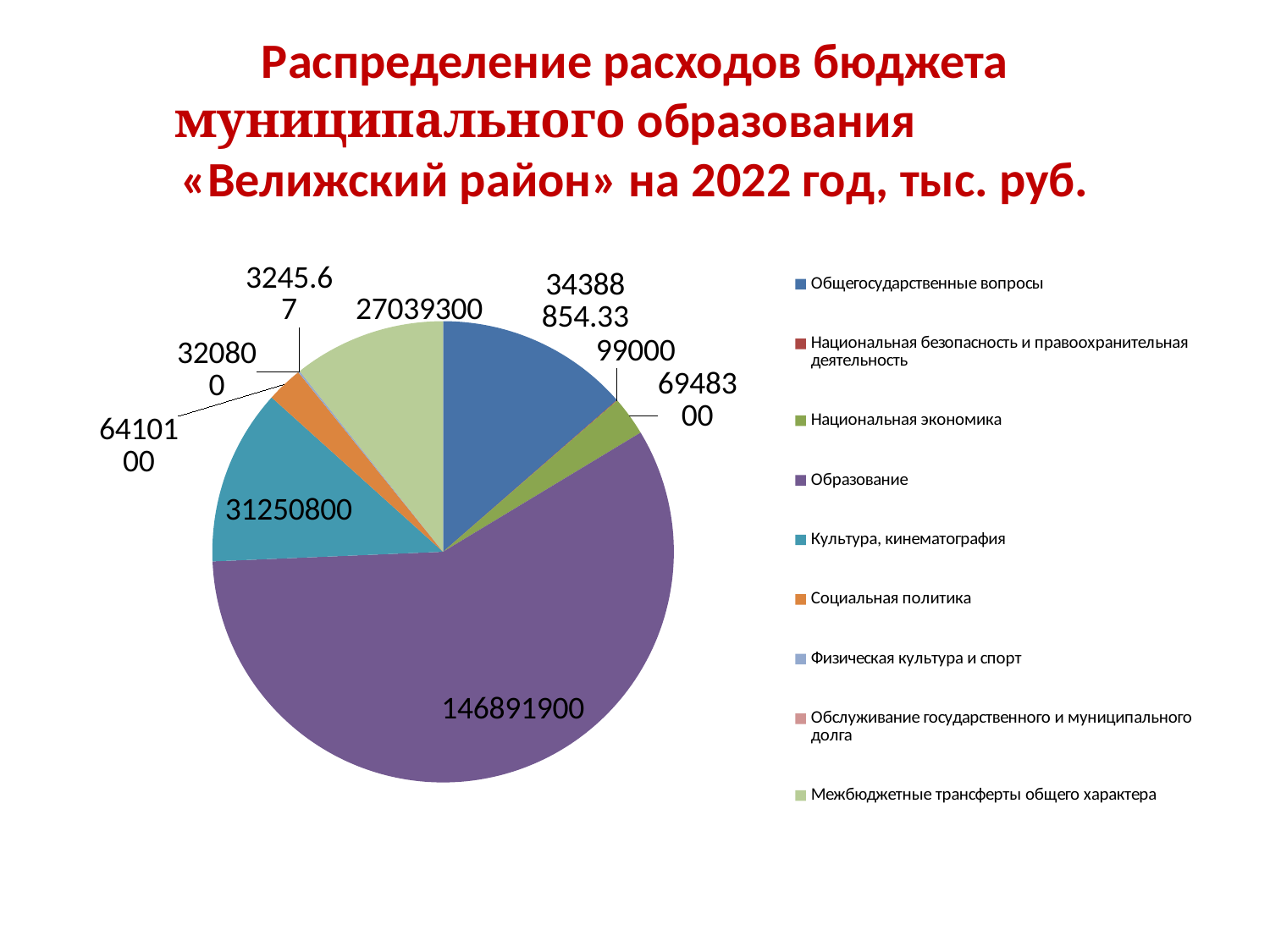
What colour is the slice for Образование? purple What is the value for Национальная экономика? 6948300 What is the value for Культура, кинематография? 31250800 How many categories does the legend of the pie chart list? 9 Which category has the largest share of the pie? Образование What is the difference between the values for Культура, кинематография and Межбюджетные трансферты общего характера? 4211500 Which is larger: Культура, кинематография or Межбюджетные трансферты общего характера? Культура, кинематография What type of chart is shown on the slide? pie chart What is the value for Социальная политика? 6410100 What is the value for Образование? 146891900 What is the value for Межбюджетные трансферты общего характера? 27039300 What is the value for Общегосударственные вопросы? 34388854.33